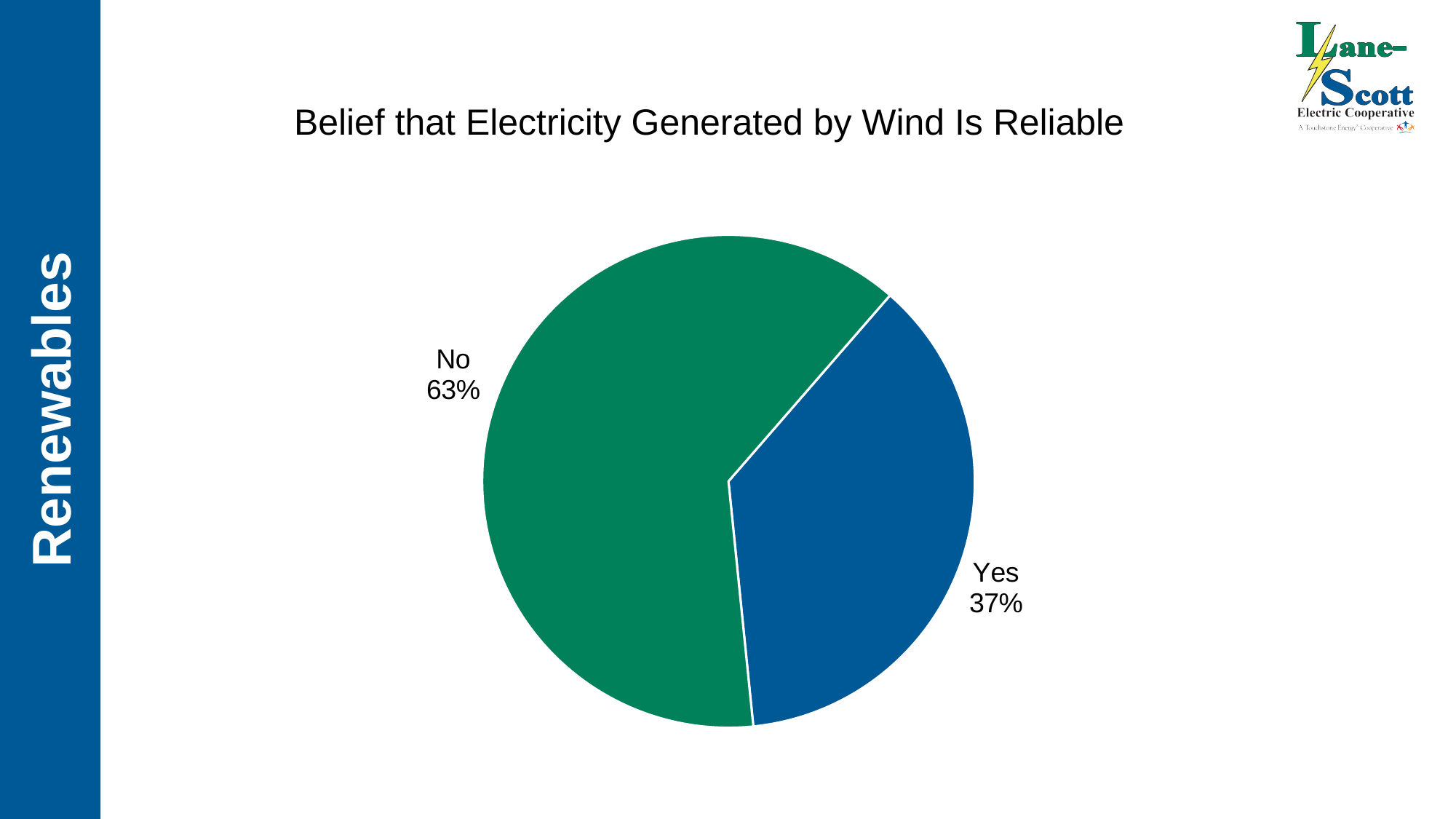
What is the difference in percentage points between the "No" and "Yes" slices? 26 What colour is the "No" slice? green What percentage of respondents answered "Yes"? 37% Which slice is the smallest? Yes What is the title of the chart? Belief that Electricity Generated by Wind Is Reliable How many slices does the pie chart have? 2 What percentage of respondents answered "No"? 63% What kind of chart is shown on the slide? pie chart What share of the pie does the "Yes" slice represent? 37% Which slice is the largest? No Which is larger, the "Yes" slice or the "No" slice? No